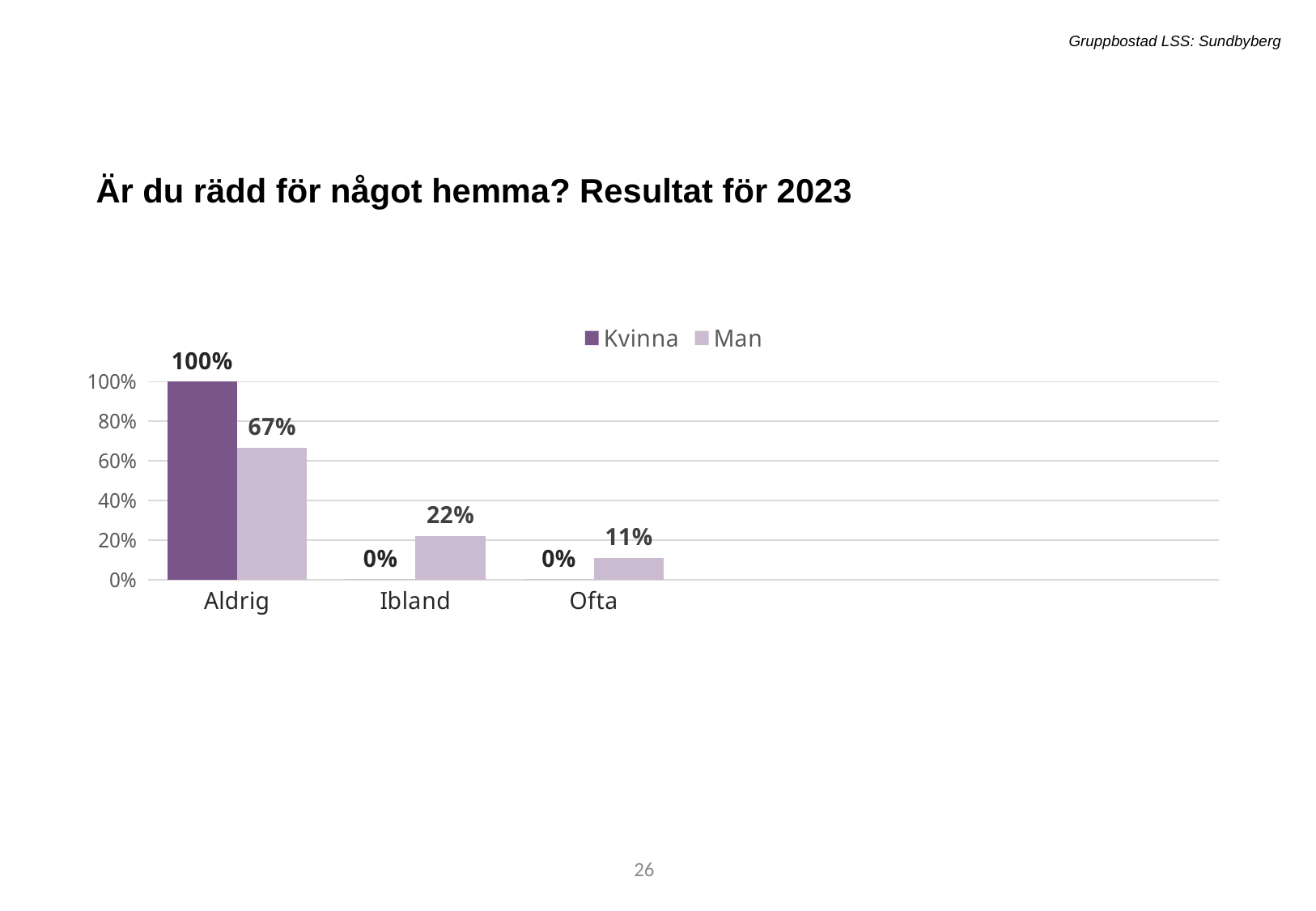
Which is larger in the Ibland category, Kvinna or Man? Man What is the value for Man in the Aldrig category? 67% Which series is shown in the darker purple colour? Kvinna What is the difference between the Kvinna and Man values in the Aldrig category? 33% How many categories are shown on the x axis? 3 What kind of chart is shown on the slide? Bar chart How many series does the legend list? 2 Which category has the highest value for Man? Aldrig What is the value for Man in the Ibland category? 22% What is the value for Kvinna in the Ofta category? 0% Which category has the lowest value for Man? Ofta What is the value for Kvinna in the Aldrig category? 100%